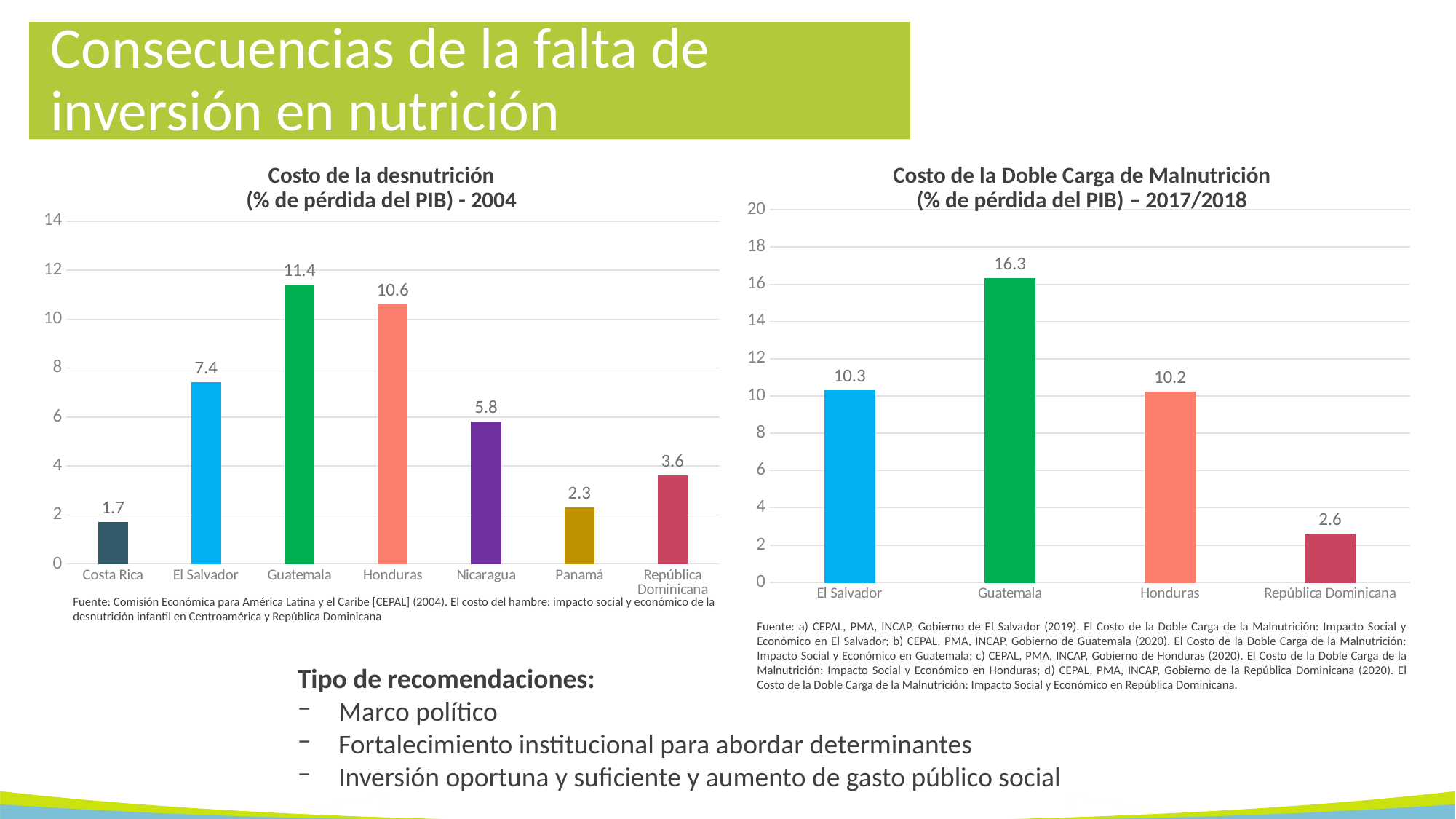
In the chart 'Costo de la desnutrición (% de pérdida del PIB) - 2004', which is larger, El Salvador or República Dominicana? El Salvador In the chart 'Costo de la Doble Carga de Malnutrición (% de pérdida del PIB) – 2017/2018', what is the value for El Salvador? 10.3 In the chart 'Costo de la desnutrición (% de pérdida del PIB) - 2004', how many countries are shown? 7 In the chart 'Costo de la Doble Carga de Malnutrición (% de pérdida del PIB) – 2017/2018', what is the difference between Guatemala and Honduras? 6.1 In the chart 'Costo de la desnutrición (% de pérdida del PIB) - 2004', what is the difference between Honduras and Nicaragua? 4.8 In the chart 'Costo de la Doble Carga de Malnutrición (% de pérdida del PIB) – 2017/2018', how many countries are shown? 4 In the chart 'Costo de la Doble Carga de Malnutrición (% de pérdida del PIB) – 2017/2018', which country has the highest value? Guatemala In the chart 'Costo de la desnutrición (% de pérdida del PIB) - 2004', what is the value for Panamá? 2.3 In the chart 'Costo de la desnutrición (% de pérdida del PIB) - 2004', what is the value for Guatemala? 11.4 In the chart 'Costo de la desnutrición (% de pérdida del PIB) - 2004', which country has the lowest value? Costa Rica What kind of chart is 'Costo de la Doble Carga de Malnutrición (% de pérdida del PIB) – 2017/2018'? Bar chart In the chart 'Costo de la Doble Carga de Malnutrición (% de pérdida del PIB) – 2017/2018', what is the value for República Dominicana? 2.6